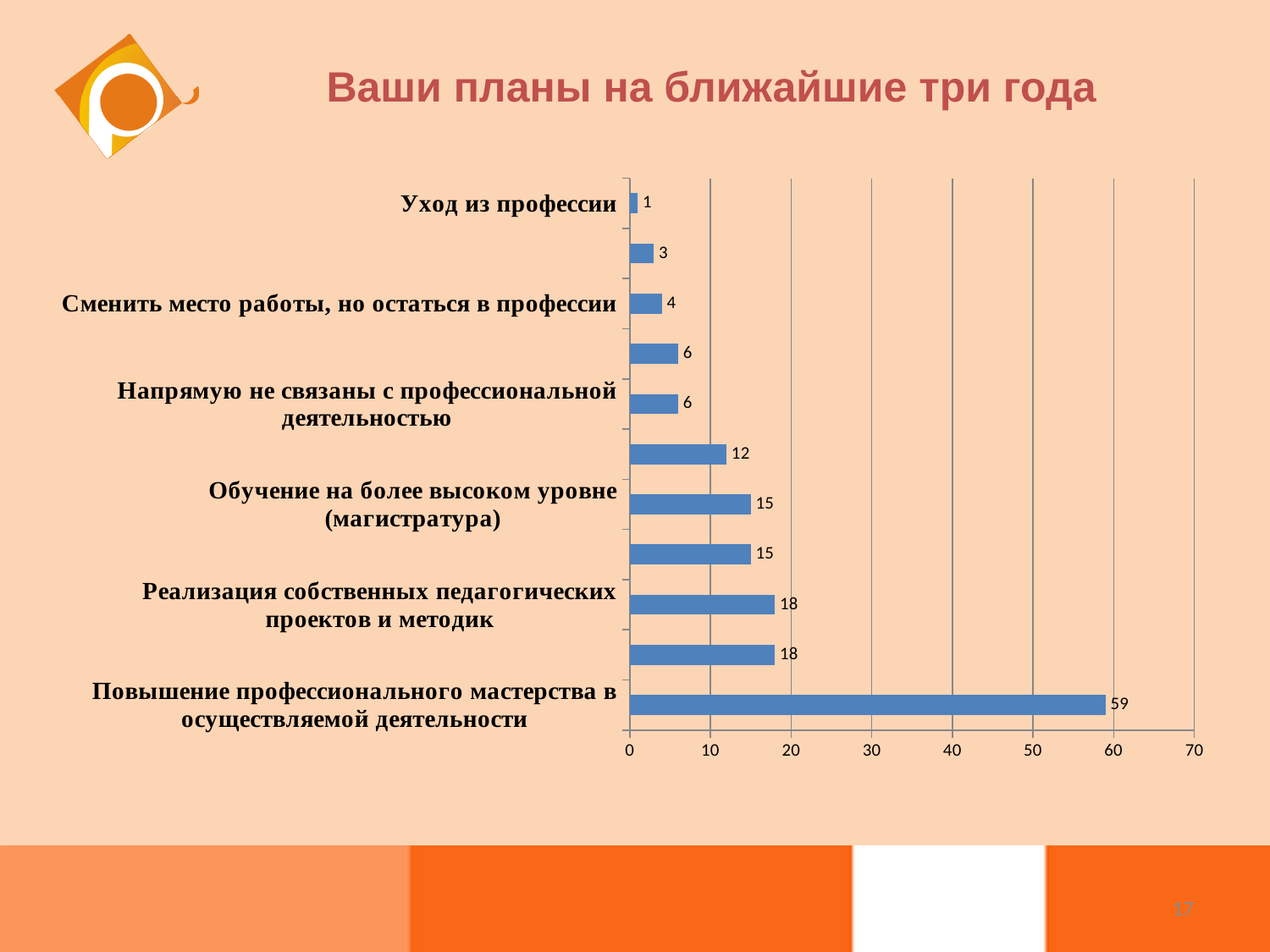
What is the value for "Повышение профессионального мастерства в осуществляемой деятельности"? 59 What is the value for "Уход из профессии"? 1 Which category has the highest value? Повышение профессионального мастерства в осуществляемой деятельности What is the title of the slide? Ваши планы на ближайшие три года Which category has the lowest value? Уход из профессии Which is larger: the value for "Напрямую не связаны с профессиональной деятельностью" or for "Сменить место работы, но остаться в профессии"? Напрямую не связаны с профессиональной деятельностью How many bars are plotted in the chart? 11 Is the value for "Повышение профессионального мастерства в осуществляемой деятельности" greater or less than 50? greater What is the value for "Обучение на более высоком уровне (магистратура)"? 15 What is the value for "Сменить место работы, но остаться в профессии"? 4 What is the difference between the values for "Повышение профессионального мастерства в осуществляемой деятельности" and "Реализация собственных педагогических проектов и методик"? 41 What kind of chart is shown on the slide? bar chart